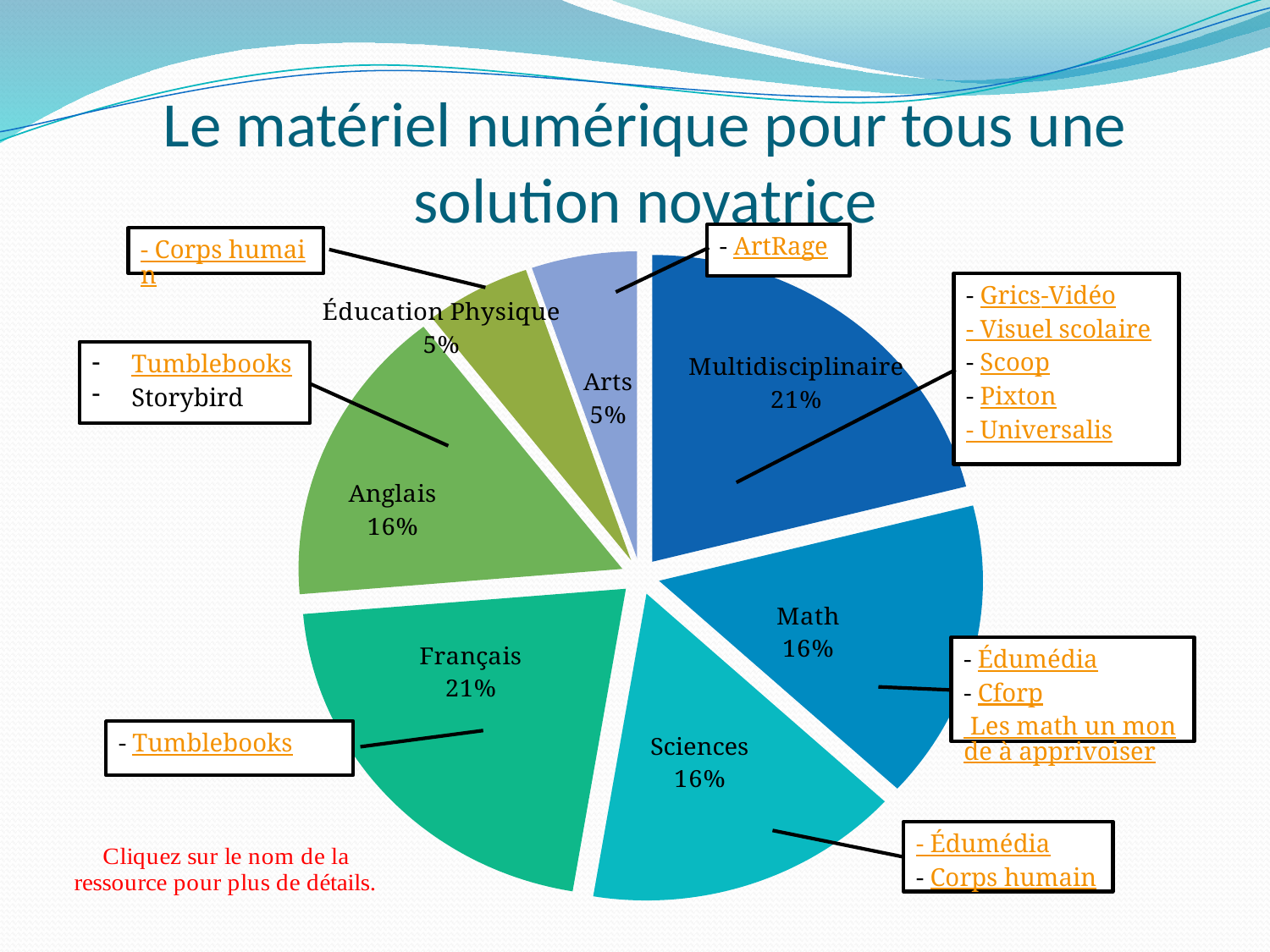
What share of the pie does Multidisciplinaire represent? 21% What percentage is shown for Math? 16% What kind of chart is shown on the slide? pie chart What share of the pie does Français represent? 21% What is the difference in percentage points between Sciences and Arts? 11% How many slices does the pie chart have? 7 Which slice is larger, Français or Math? Français What is the difference in percentage points between Multidisciplinaire and Anglais? 5% What percentage is shown for Anglais? 16% What percentage is shown for Arts? 5% What percentage is shown for Éducation Physique? 5% What percentage is shown for Sciences? 16%